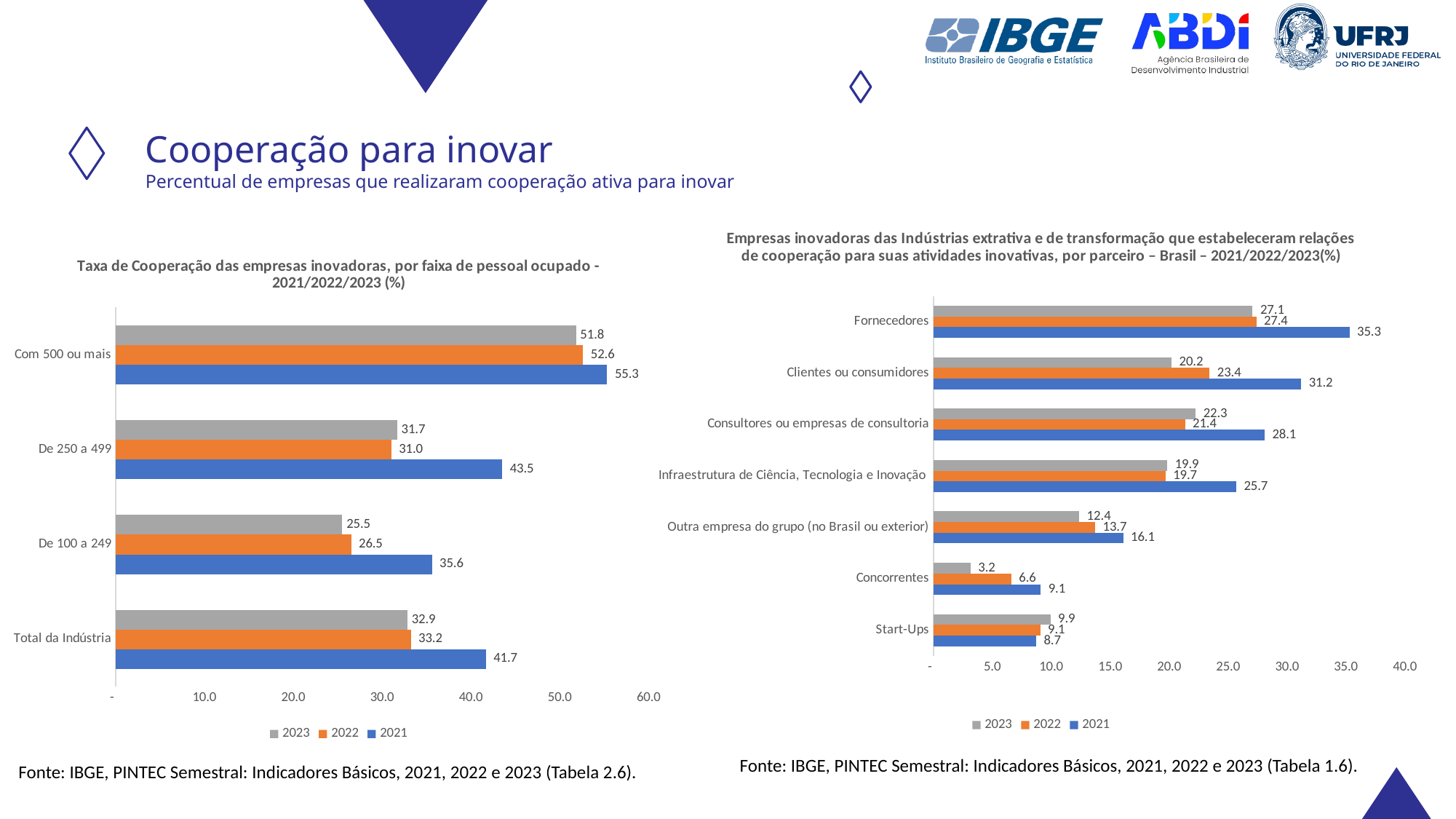
In the right chart (Empresas inovadoras ... por parceiro), what is the 2021 value for Fornecedores? 35.3 In the left chart (Taxa de Cooperação das empresas inovadoras, por faixa de pessoal ocupado), what is the 2023 value for Total da Indústria? 32.9 In the right chart (Empresas inovadoras ... por parceiro), which partner category has the lowest 2021 value? Start-Ups In the left chart (Taxa de Cooperação das empresas inovadoras, por faixa de pessoal ocupado), how many series does the legend list? 3 In the left chart (Taxa de Cooperação das empresas inovadoras, por faixa de pessoal ocupado), what is the difference between the 2021 and 2023 values for De 250 a 499? 11.8 In the left chart (Taxa de Cooperação das empresas inovadoras, por faixa de pessoal ocupado), which category has the highest 2022 value? Com 500 ou mais In the left chart (Taxa de Cooperação das empresas inovadoras, por faixa de pessoal ocupado), what is the 2021 value for Com 500 ou mais? 55.3 In the right chart (Empresas inovadoras ... por parceiro), what is the difference between the 2021 and 2022 values for Outra empresa do grupo (no Brasil ou exterior)? 2.4 In the right chart (Empresas inovadoras ... por parceiro), what is the 2023 value for Concorrentes? 3.2 In the right chart (Empresas inovadoras ... por parceiro), how many partner categories are shown? 7 In the left chart (Taxa de Cooperação das empresas inovadoras, por faixa de pessoal ocupado), what kind of chart is shown? Bar chart In the right chart (Empresas inovadoras ... por parceiro), which is larger for Clientes ou consumidores: the 2022 value or the 2023 value? 2022